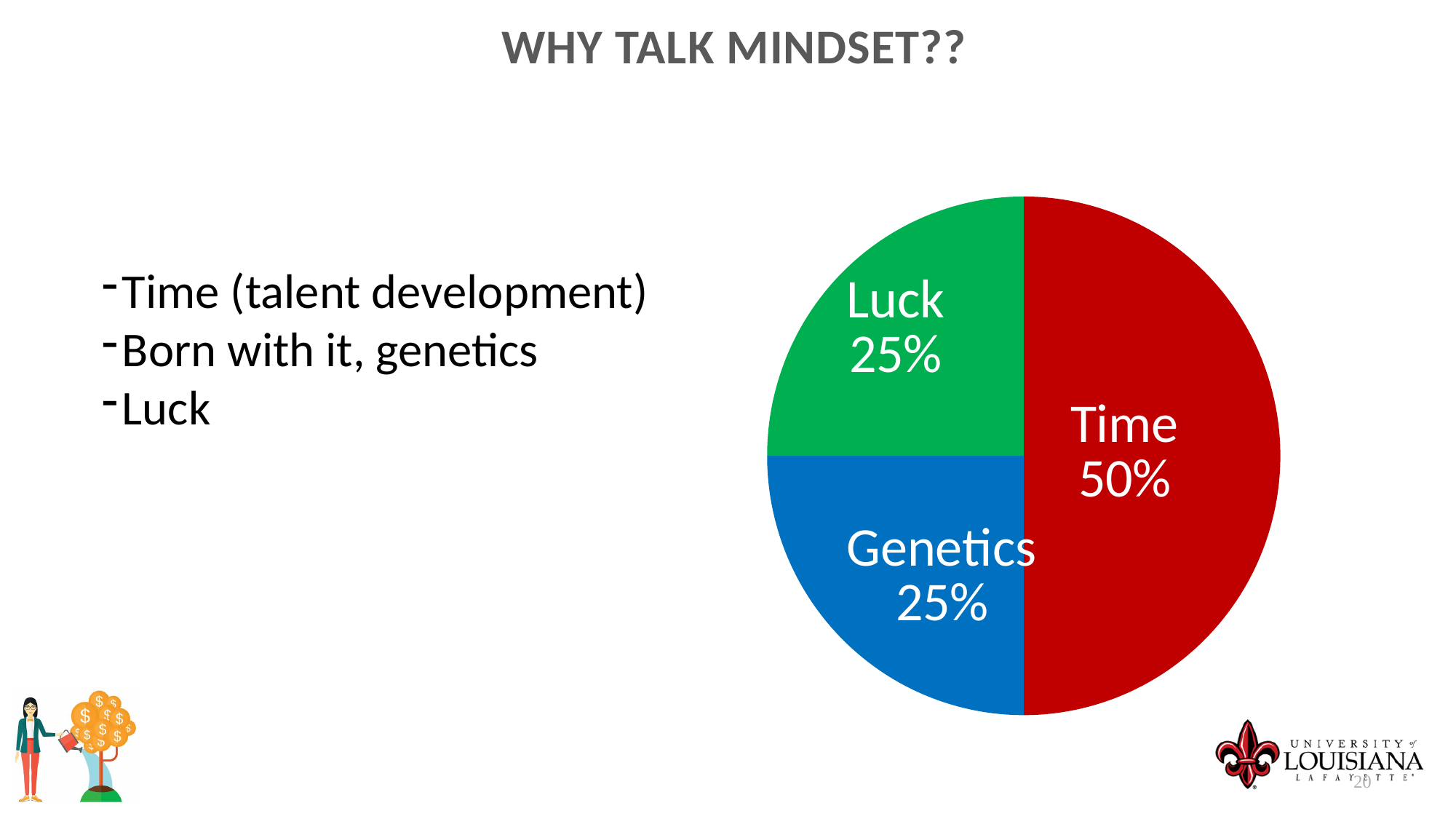
What kind of chart is shown on the slide? Pie chart Which slice of the pie is the largest? Time Which is larger, the Time slice or the Genetics slice? Time What percentage does the Time slice represent? 50% What percentage does the Luck slice represent? 25% What share of the pie do Luck and Genetics make up together? 50% How many slices does the pie chart have? 3 What percentage does the Genetics slice represent? 25% What colour is the Luck slice? Green What is the difference between the Time share and the Luck share? 25% What colour is the Time slice? Red